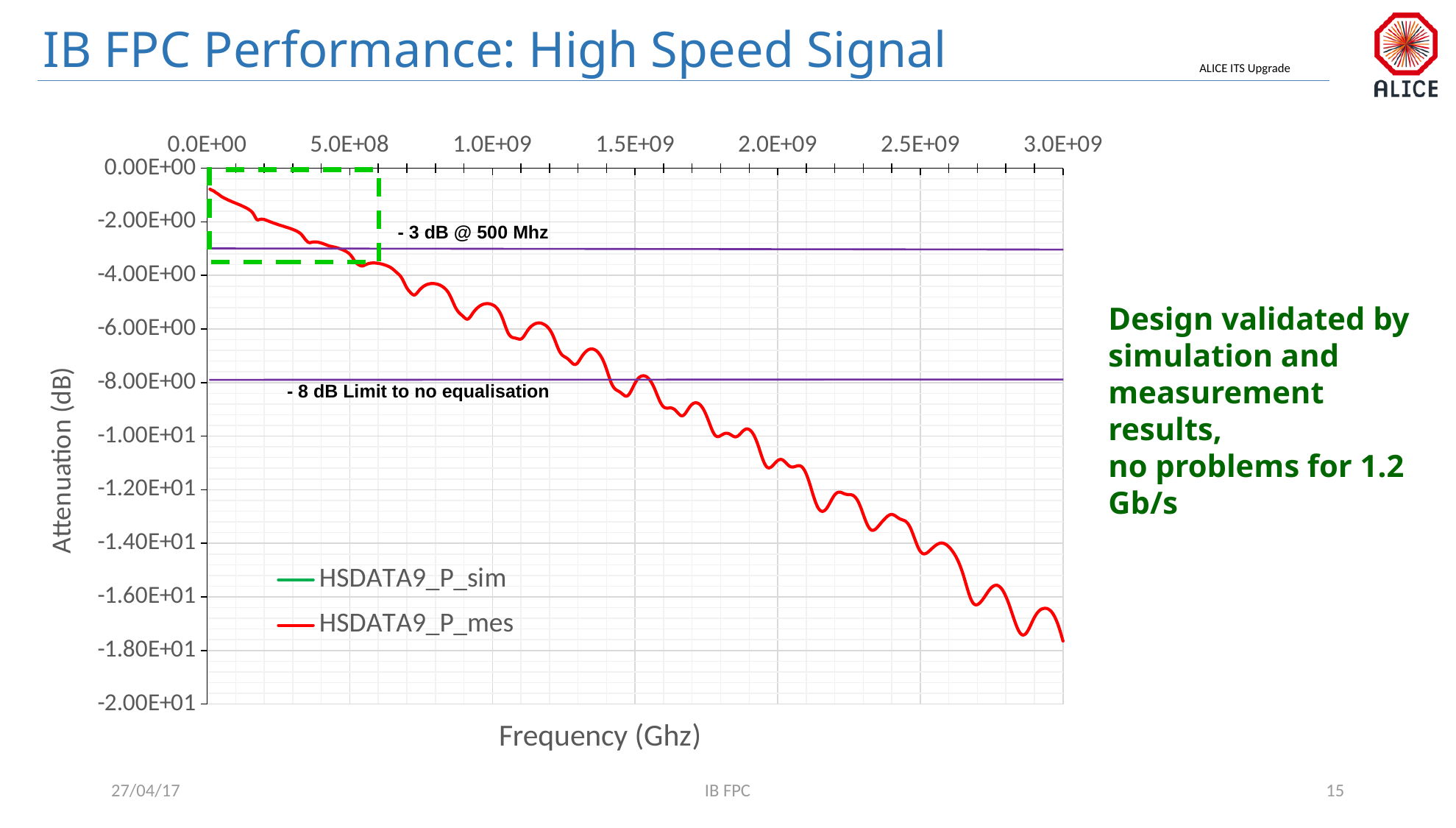
Is the HSDATA9_P_mes value at 3.0E+09 greater or less than -1.60E+01? less Which series is drawn in red in the chart? HSDATA9_P_mes Is the HSDATA9_P_mes value at 1.0E+09 greater or less than -4.00E+00? less Is the HSDATA9_P_mes value at 5.0E+08 greater or less than -2.00E+00? less What attenuation level is labelled as the limit to no equalisation? -8 dB What attenuation level does the upper horizontal reference line in the chart mark? -3 dB Does the HSDATA9_P_mes attenuation rise or fall as frequency increases along the x axis? fall What kind of chart is shown on the slide? line chart What is the label of the chart's y axis? Attenuation (dB) How many series does the chart legend list? 2